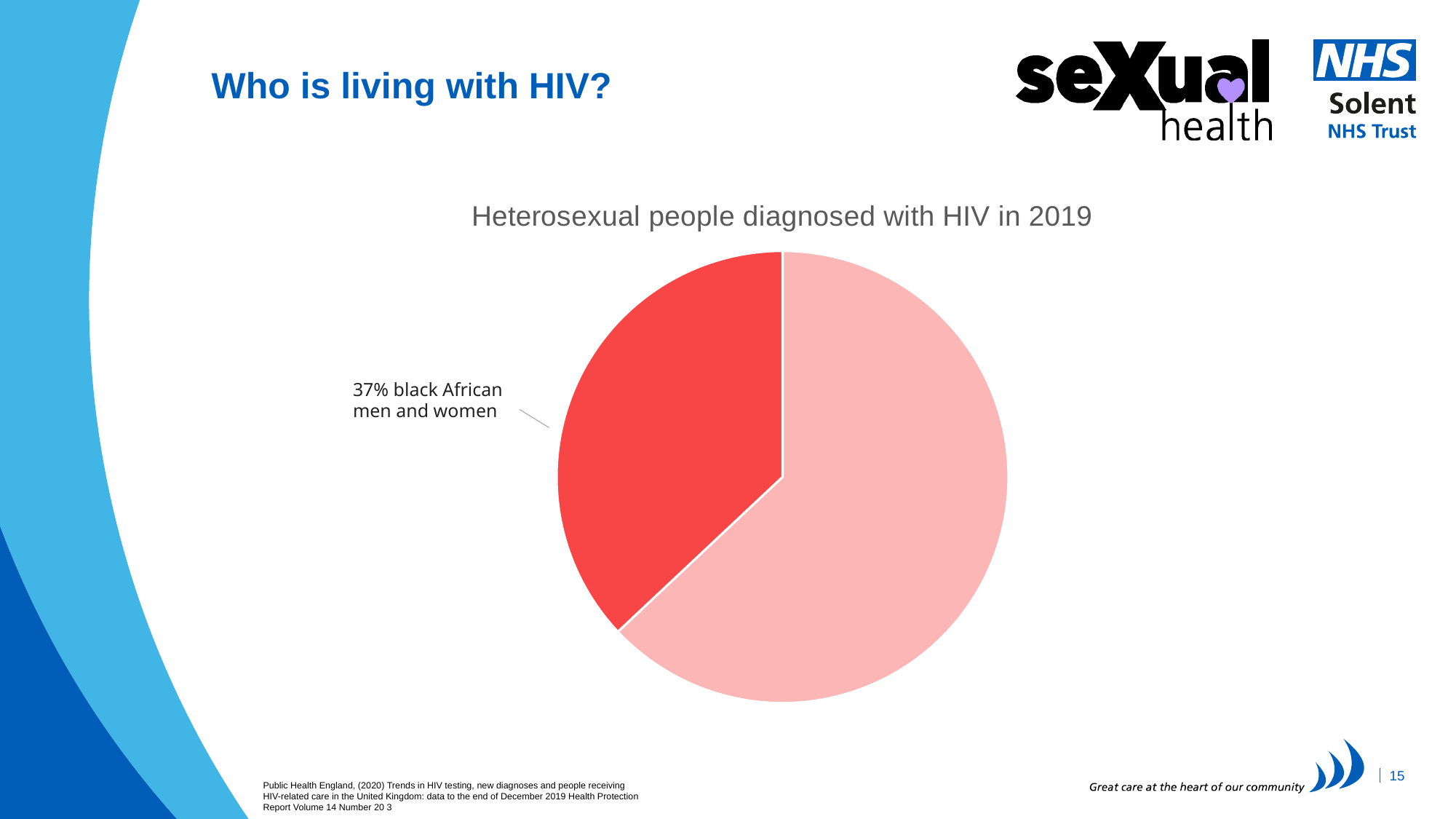
How many slices of the pie chart have a data label? 1 Which year does the pie chart's data refer to? 2019 What is the title of the chart? Heterosexual people diagnosed with HIV in 2019 What share of heterosexual people diagnosed with HIV in 2019 were black African men and women? 37% What colour is the slice representing black African men and women? red Is the share for black African men and women greater or less than 50%? less Is the slice for black African men and women larger or smaller than the other slice of the pie? smaller What kind of chart is shown on the slide? pie chart How many slices does the pie chart have? 2